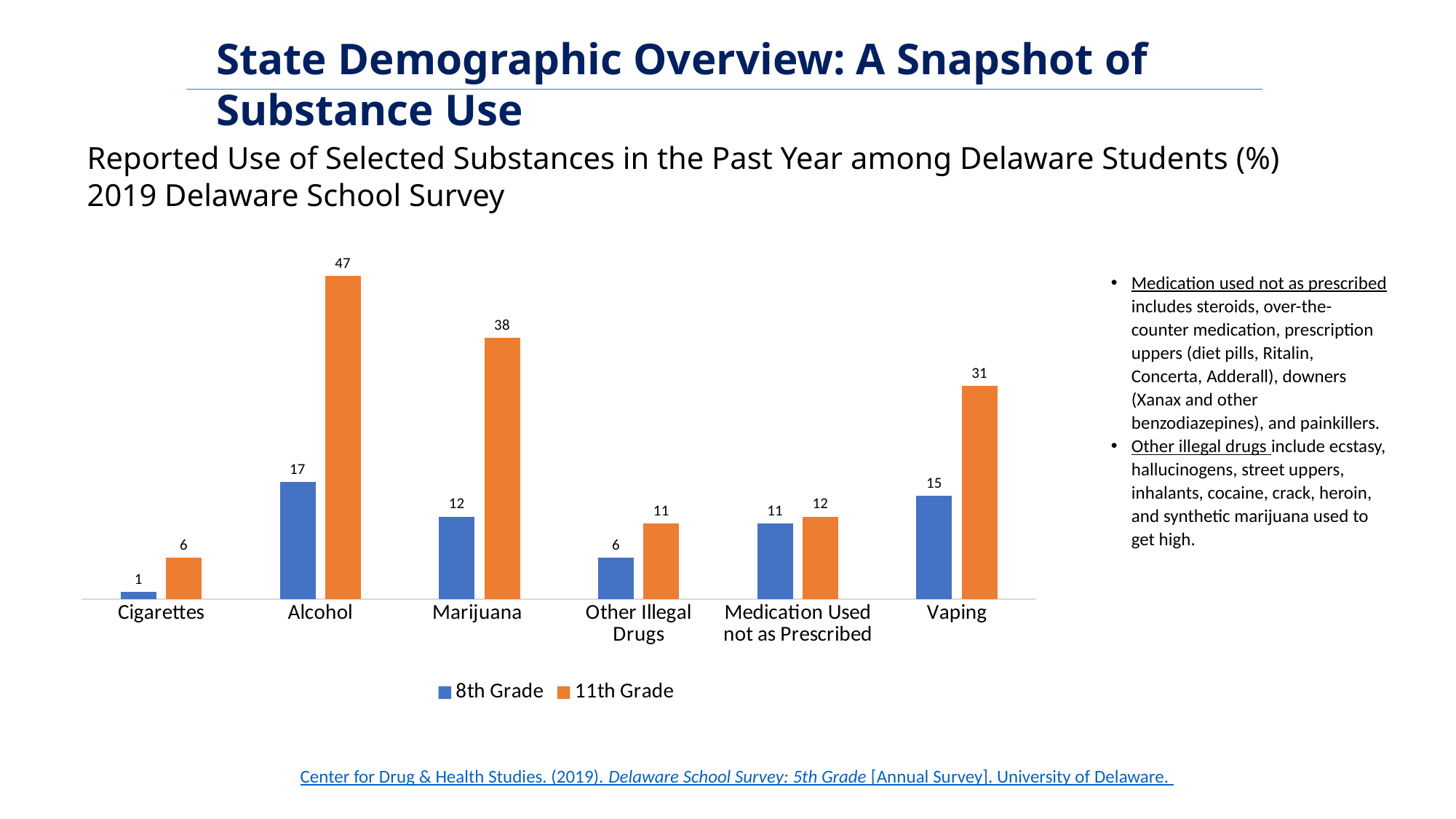
What is the value for Cigarettes in the 8th Grade series? 1 How many substance categories are shown on the x axis? 6 How many series does the legend list? 2 Which category has the highest value in the 11th Grade series? Alcohol What is the difference between the 11th Grade and 8th Grade values for Medication Used not as Prescribed? 1 Which is larger: the 11th Grade value for Vaping or the 11th Grade value for Marijuana? Marijuana What is the difference between the 11th Grade and 8th Grade values for Marijuana? 26 Which series is shown in orange in the legend? 11th Grade What kind of chart is shown on the slide? Bar chart What is the value for Alcohol in the 11th Grade series? 47 What is the value for Vaping in the 8th Grade series? 15 Which category has the lowest value in the 8th Grade series? Cigarettes